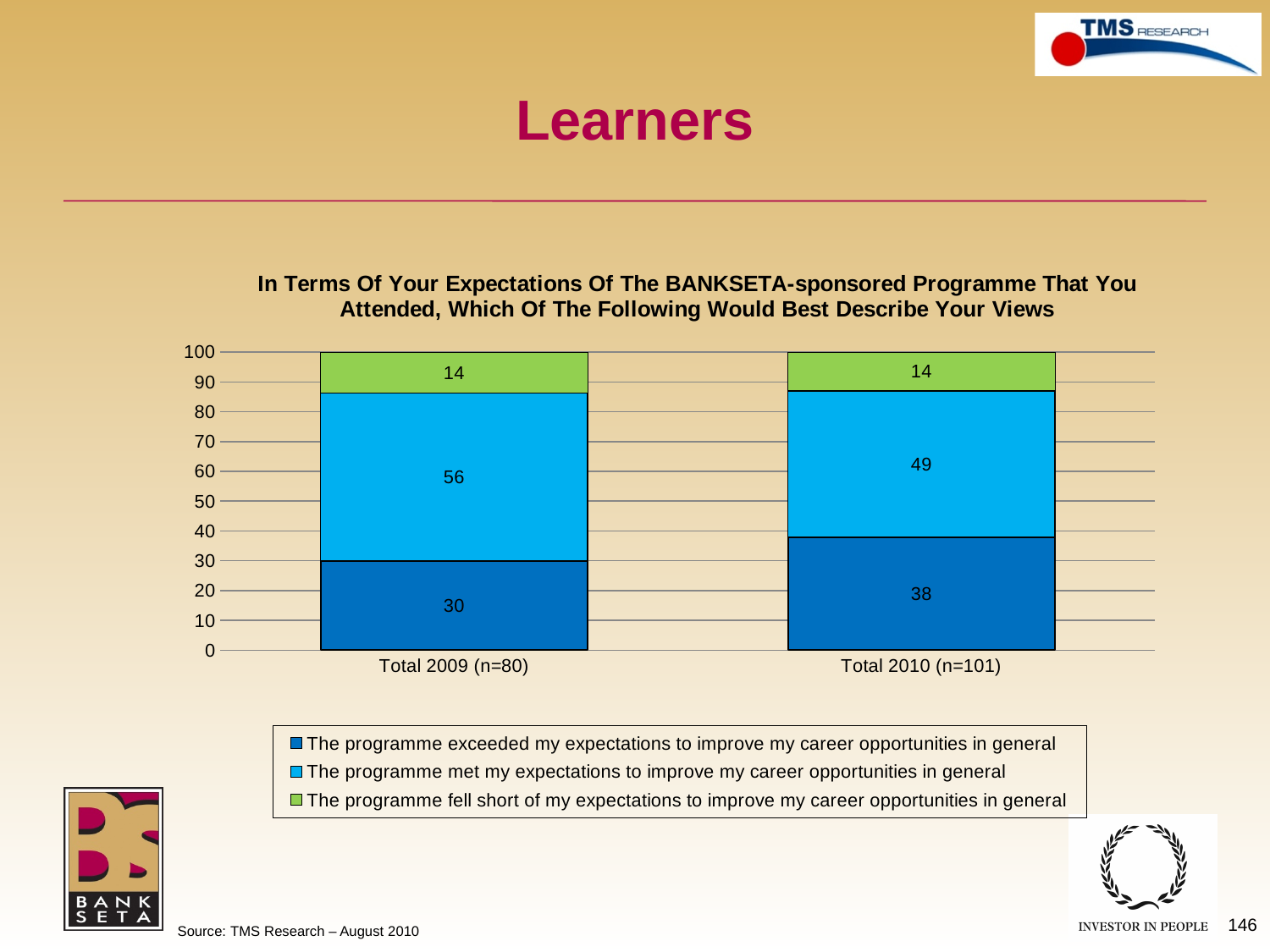
What is the value for 'The programme exceeded my expectations to improve my career opportunities in general' for Total 2009 (n=80)? 30 What kind of chart is shown on the slide? Stacked bar chart How many series does the legend list? 3 What is the value for 'The programme exceeded my expectations to improve my career opportunities in general' for Total 2010 (n=101)? 38 How many categories are shown on the x axis? 2 What is the value for 'The programme fell short of my expectations to improve my career opportunities in general' for Total 2009 (n=80)? 14 What is the total of the stacked bar for Total 2009 (n=80)? 100 Which series is shown in green in the legend? The programme fell short of my expectations to improve my career opportunities in general Which year has the larger value for 'The programme exceeded my expectations to improve my career opportunities in general', Total 2009 (n=80) or Total 2010 (n=101)? Total 2010 (n=101) What is the total of the stacked bar for Total 2010 (n=101)? 101 What is the difference between the 'met my expectations' values for Total 2009 (n=80) and Total 2010 (n=101)? 7 What is the value for 'The programme met my expectations to improve my career opportunities in general' for Total 2010 (n=101)? 49